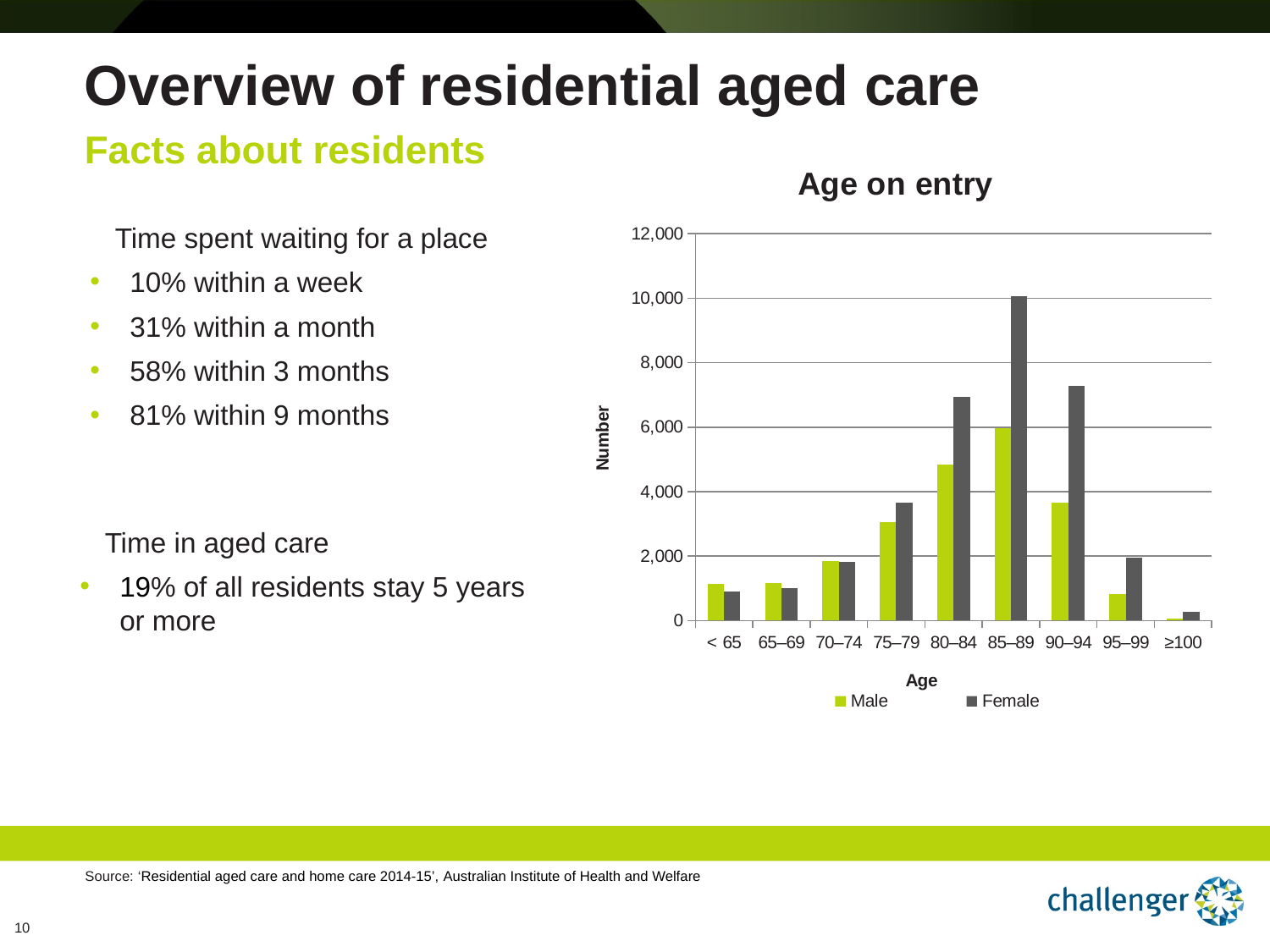
What kind of chart is the 'Age on entry' chart? bar chart In the 90–94 age group, which is larger, the Male or the Female value? Female Which age group has the highest Male value in the 'Age on entry' chart? 85–89 How many series does the legend of the 'Age on entry' chart list? 2 How many age categories are shown on the x axis of the 'Age on entry' chart? 9 Which age group has the highest Female value in the 'Age on entry' chart? 85–89 In the < 65 age group, which is larger, the Male or the Female value? Male Is the Male value for the 80–84 age group greater or less than 4,000? greater What is the label of the y axis in the 'Age on entry' chart? Number Which age group has the lowest Male value in the 'Age on entry' chart? ≥100